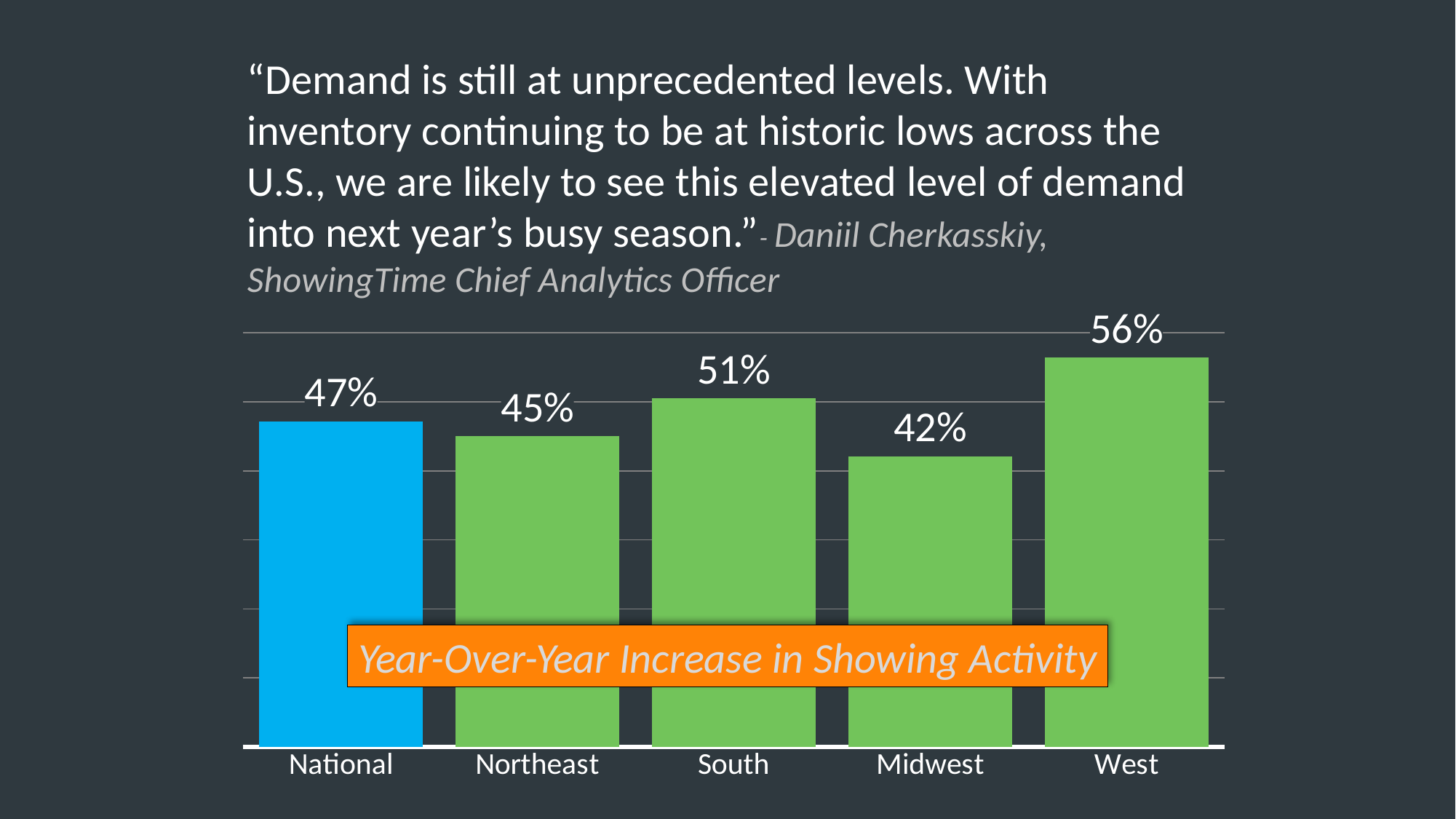
Which is larger, the value for the Northeast or the value for the South? South What is the year-over-year increase in showing activity for the West? 56% How many categories are shown on the chart? 5 Which category has the lowest value on the chart? Midwest What is the National year-over-year increase in showing activity? 47% What kind of chart is shown on the slide? Bar chart What is the difference between the West and Midwest values? 14% What is the title shown on the orange banner over the chart? Year-Over-Year Increase in Showing Activity What is the value shown for the South? 51% What is the year-over-year increase in showing activity for the Midwest? 42% What is the difference between the South and Northeast values? 6% Which region has the highest year-over-year increase in showing activity? West